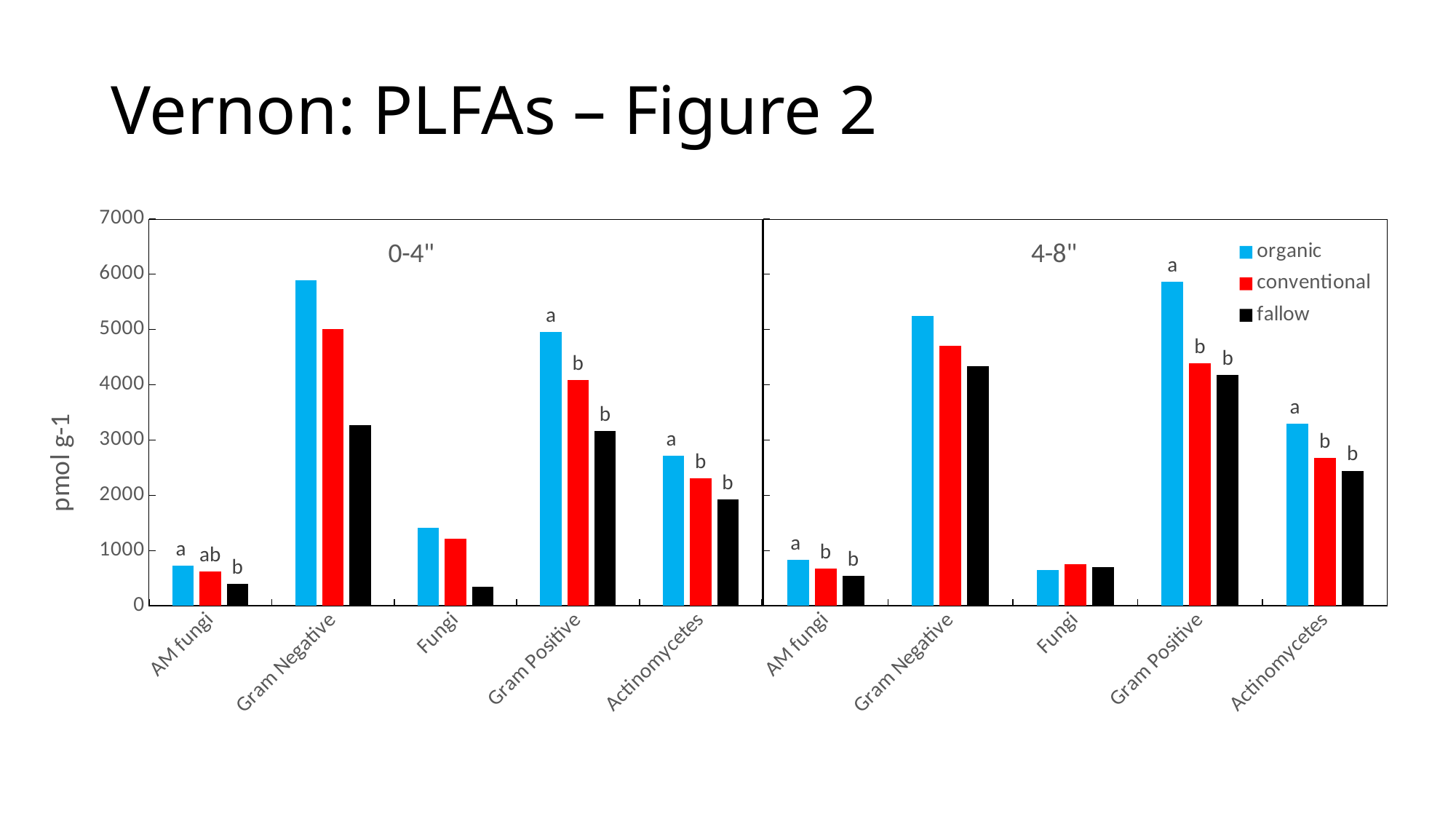
In the 0-4" panel, how many categories are shown on the x axis? 5 In the 0-4" panel, is the fallow value for Fungi greater or less than 1000? less In the 0-4" panel, which is larger for Gram Positive: the conventional value or the fallow value? conventional What kind of chart is shown on the slide? bar chart What is the label on the y axis? pmol g-1 Which colour represents the fallow series in the legend? black In the 0-4" panel, which category and series has the lowest bar? Fungi, fallow In the 0-4" panel, which category and series has the highest bar? Gram Negative, organic How many series does the legend list? 3 In the 0-4" panel, is the organic value for Gram Negative greater or less than 5000? greater In the 4-8" panel, which is larger: the organic value for Gram Positive or the organic value for Gram Negative? Gram Positive In the 4-8" panel, is the organic value for Actinomycetes greater or less than 3000? greater